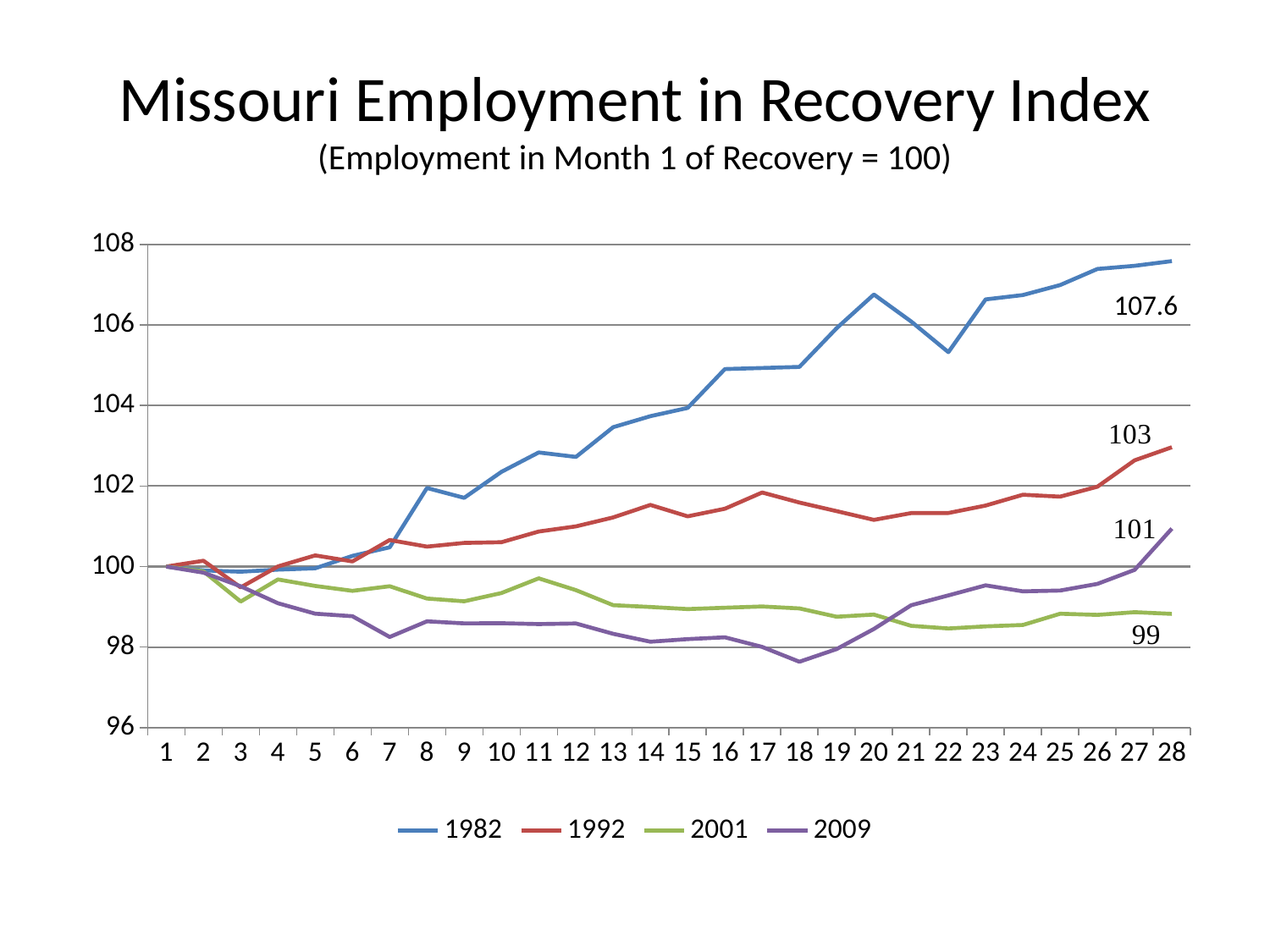
What is the value of the 2001 series at month 28? 99 Is the value for the 2009 series at month 18 greater or less than 98? less What is the difference between the 1982 and 1992 values at month 28? 4.6 How many months are shown along the x axis? 28 Which series has the highest value at month 28? 1982 What is the value of the 1992 series at month 28? 103 Which series has the lowest value at month 28? 2001 What is the value of the 2009 series at month 28? 101 What is the value of the 1982 series at month 28? 107.6 What type of chart is shown on the slide? line chart Is the value for the 1982 series at month 20 greater or less than 106? greater How many series does the legend list? 4